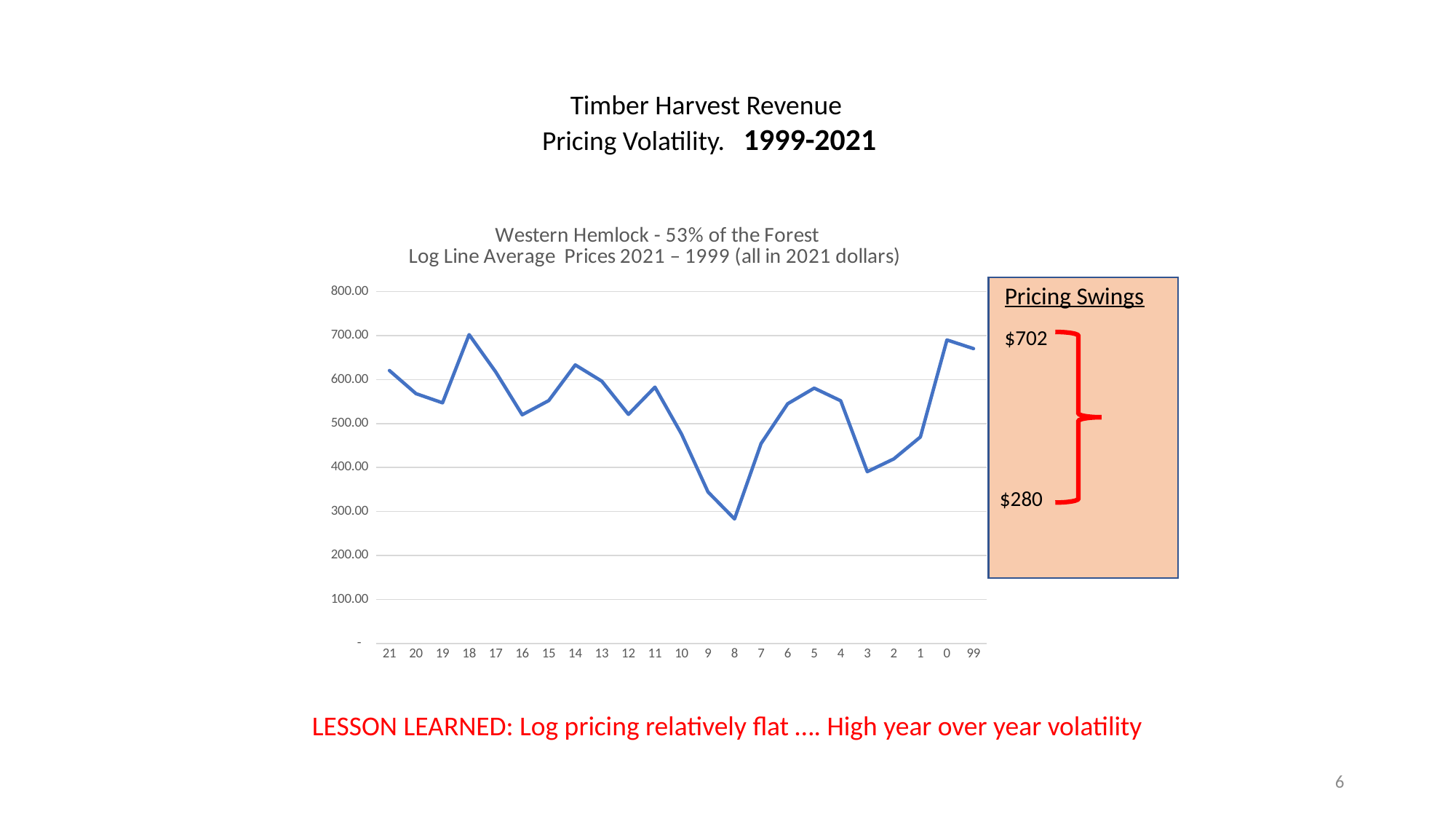
How many points are plotted along the x axis of the line chart? 23 Which has the larger value, 21 or 9? 21 Is the value for 8 greater or less than 400? less Which x-axis label has the highest value on the line chart? 18 Which has the larger value, 18 or 8? 18 Is the value for 18 greater or less than 600? greater Is the value for 0 greater or less than 600? greater Which x-axis label has the lowest value on the line chart? 8 According to the Pricing Swings box, what are the high and low prices shown? $702 and $280 What kind of chart is shown on the slide? line chart